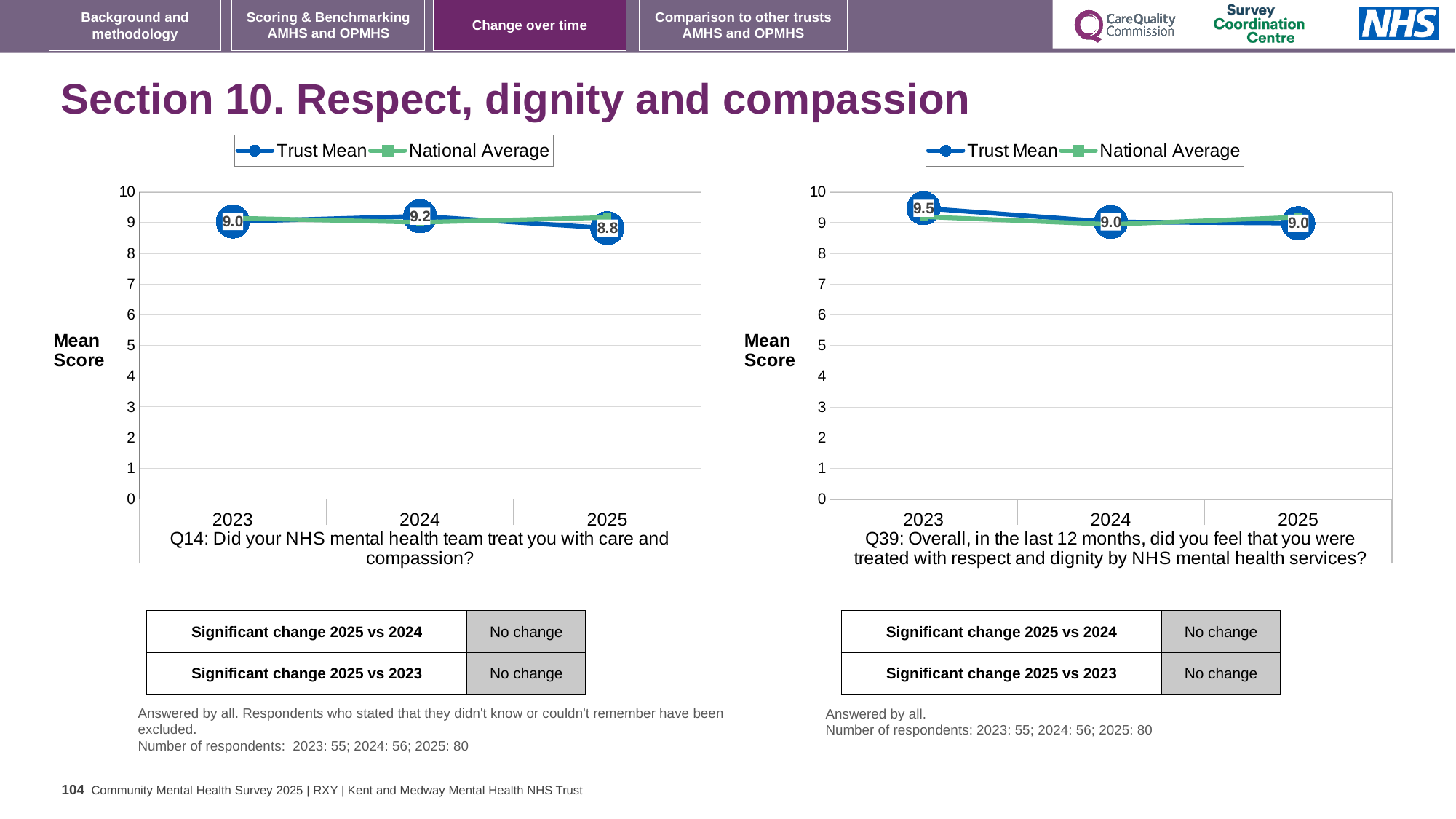
How many series does the legend of the right chart (Q39) list? 2 What kind of chart is the left chart (Q14)? Line chart In the right chart (Q39), what is the difference between the Trust Mean scores for 2023 and 2025? 0.5 In the right chart (Q39), what is the Trust Mean score for 2025? 9.0 In the left chart (Q14), which year has the highest Trust Mean score? 2024 In the right chart (Q39), does the Trust Mean score rise or fall from 2023 to 2024? Fall In the left chart (Q14), what is the difference between the Trust Mean scores for 2024 and 2025? 0.4 In the left chart (Q14), what is the Trust Mean score for 2025? 8.8 In the left chart (Q14), what is the Trust Mean score for 2024? 9.2 In the left chart (Q14), is the Trust Mean score for 2023 or 2025 larger? 2023 In the right chart (Q39), which year has the highest Trust Mean score? 2023 In the right chart (Q39), what is the Trust Mean score for 2023? 9.5